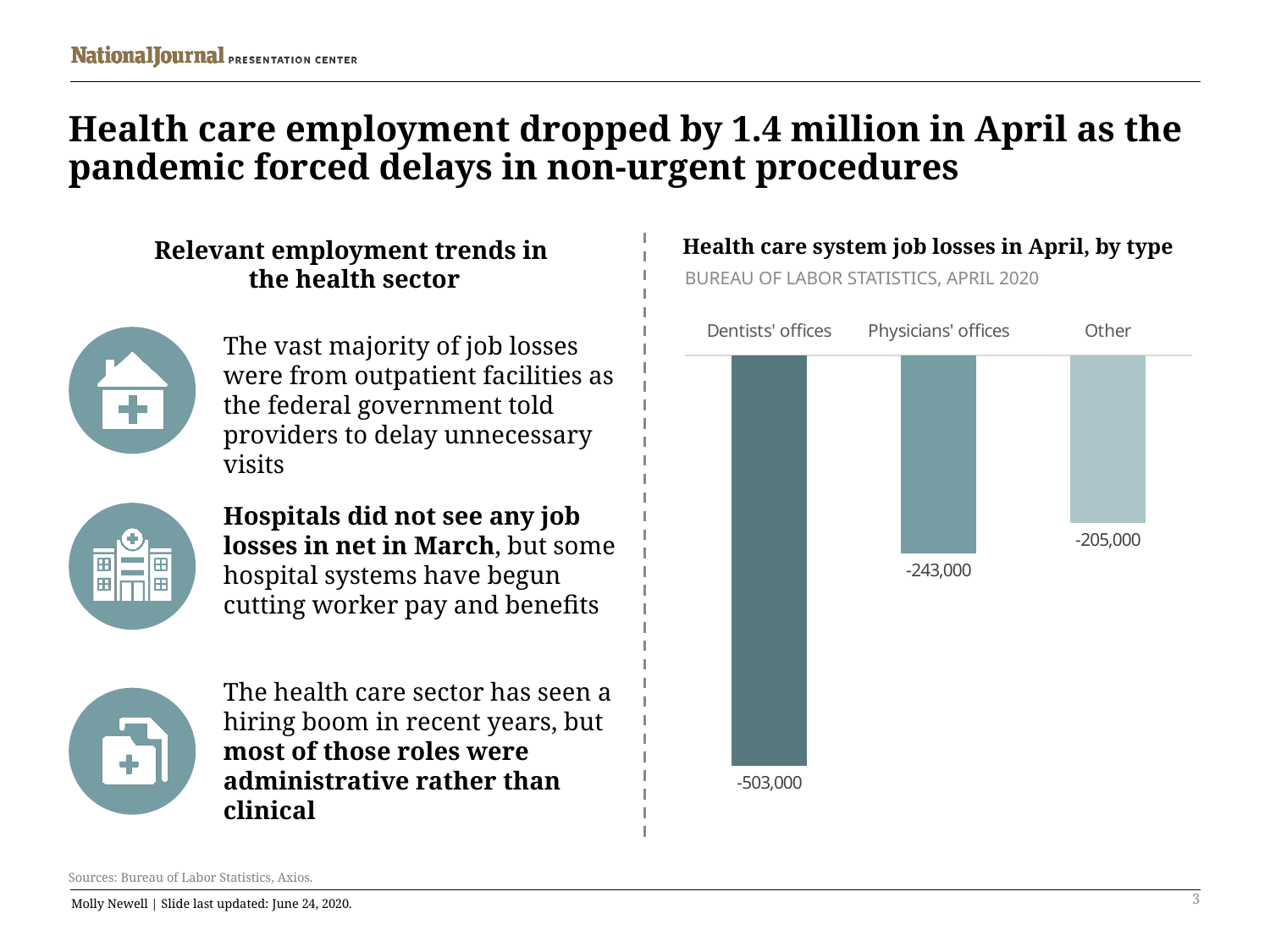
Which category shows the smallest job loss in the chart? Other How many categories are shown in the chart? 3 What is the value shown for Physicians' offices in the chart? -243,000 What is the value shown for the Other category in the chart? -205,000 Which category shows the largest job loss in the chart? Dentists' offices What is the title of the chart? Health care system job losses in April, by type Which category had a larger job loss, Physicians' offices or Other? Physicians' offices What is the combined job loss across all three categories in the chart? -951,000 How many more jobs were lost in Dentists' offices than in Physicians' offices? 260,000 What is the value shown for Dentists' offices in the chart? -503,000 How many more jobs were lost in Physicians' offices than in the Other category? 38,000 What kind of chart is used to show the health care system job losses? Bar chart